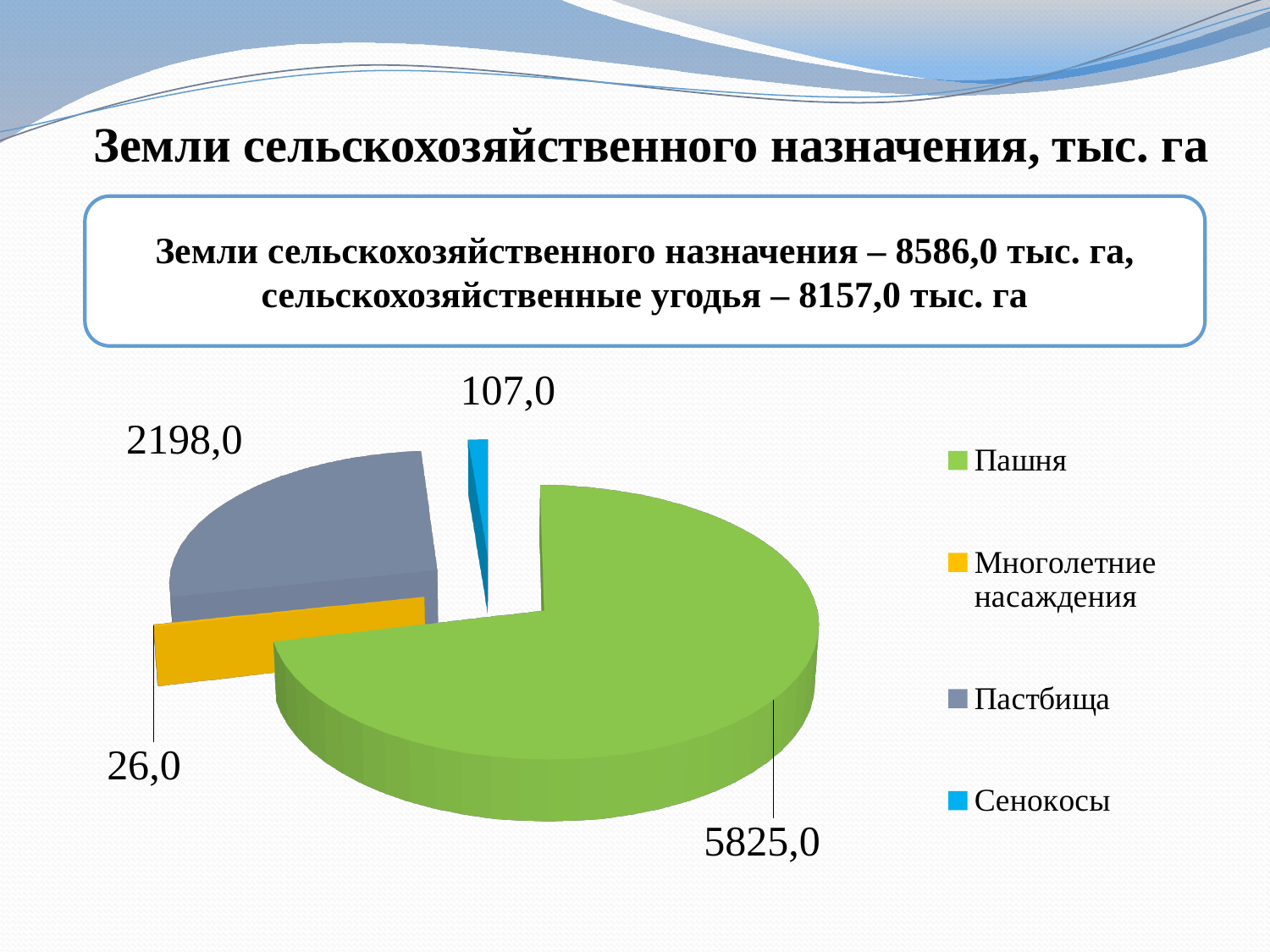
What is the value for Многолетние насаждения? 26,0 What is the difference between the values for Сенокосы and Многолетние насаждения? 81,0 Which is larger, the value for Пастбища or the value for Сенокосы? Пастбища What is the value for Пашня? 5825,0 What is the value for Пастбища? 2198,0 How many categories does the pie chart show? 4 What type of chart is shown on the slide? pie chart What is the value for Сенокосы? 107,0 Which category has the smallest slice of the pie? Многолетние насаждения What is the difference between the values for Пашня and Пастбища? 3627,0 Which category has the largest slice of the pie? Пашня What colour is the slice for Пастбища? grey